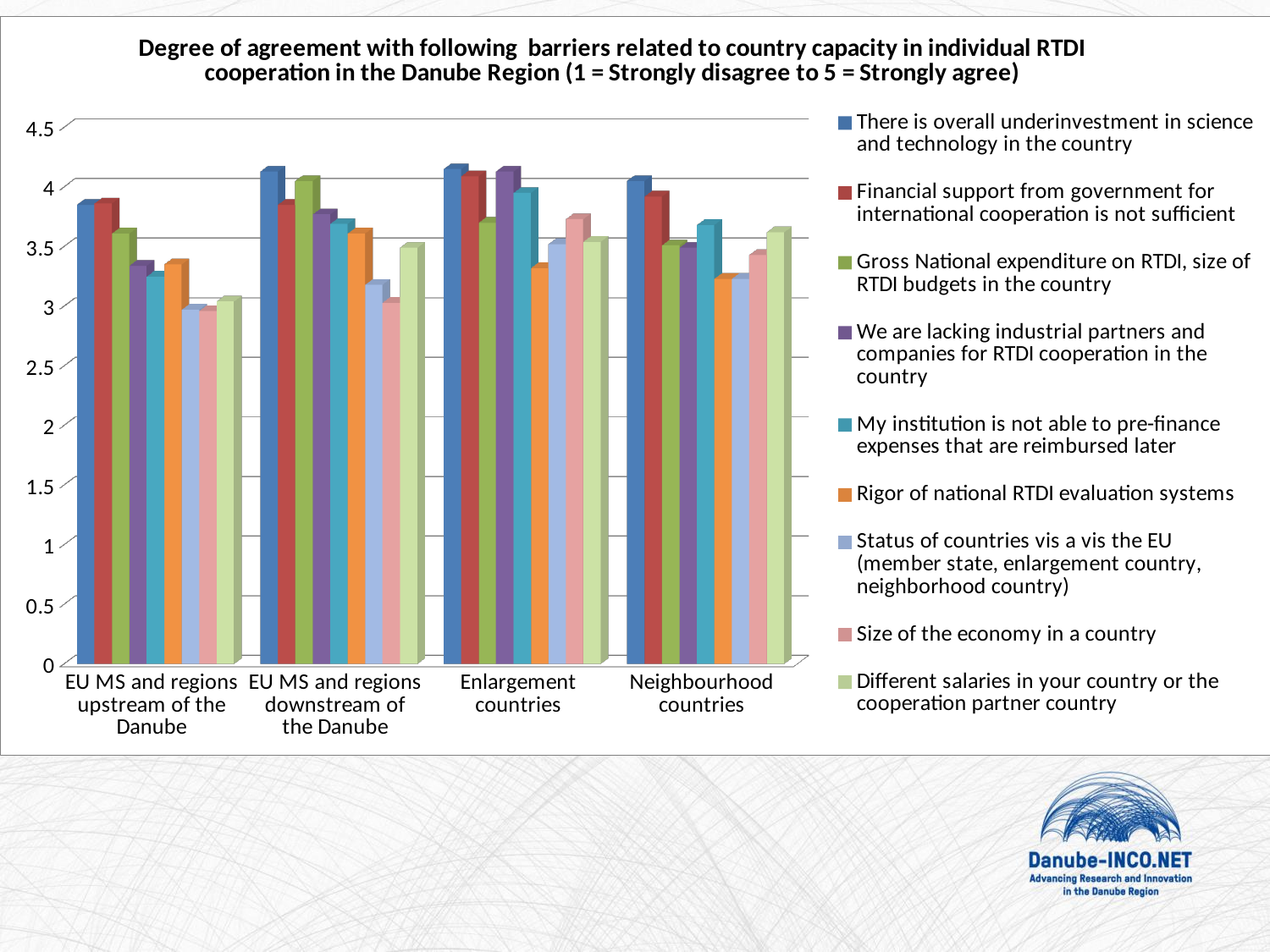
For 'Status of countries vis a vis the EU', which group has the larger value: Enlargement countries or EU MS and regions upstream of the Danube? Enlargement countries Is the value for 'My institution is not able to pre-finance expenses that are reimbursed later' for Enlargement countries greater or less than 3.5? greater What scale is used for the degree of agreement, according to the chart title? 1 = Strongly disagree to 5 = Strongly agree Is the value for 'There is overall underinvestment in science and technology in the country' for Enlargement countries greater or less than 4? greater Is the value for 'Financial support from government for international cooperation is not sufficient' for Neighbourhood countries greater or less than 3.5? greater How many country groups (categories) are shown on the x axis? 4 Which barrier has the lowest degree of agreement among Enlargement countries? Rigor of national RTDI evaluation systems What kind of chart is shown on the slide? Bar chart Which barrier has the highest degree of agreement among Neighbourhood countries? There is overall underinvestment in science and technology in the country How many series does the legend list? 9